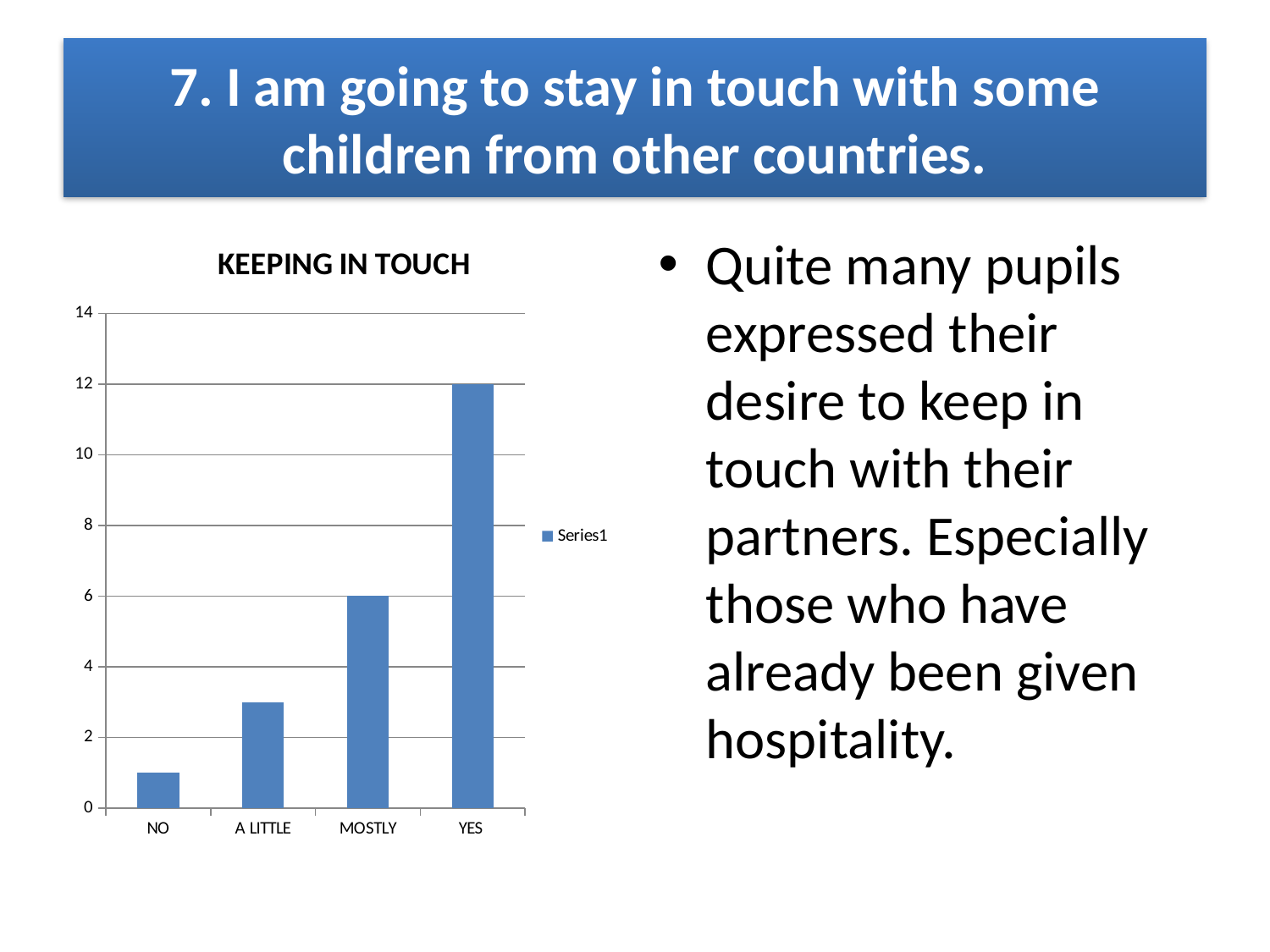
What is the difference between the values for YES and MOSTLY? 6 Which is larger, the value for A LITTLE or the value for MOSTLY? MOSTLY What is the value for MOSTLY? 6 Which category has the lowest value? NO How many categories are shown on the x axis of the chart? 4 Is the value for NO greater or less than 2? less Do the values rise or fall from NO to YES along the x axis? rise How many series does the chart legend list? 1 Which category has the highest value? YES What kind of chart is shown on the slide? bar chart What is the value for YES? 12 What is the title of the chart? KEEPING IN TOUCH